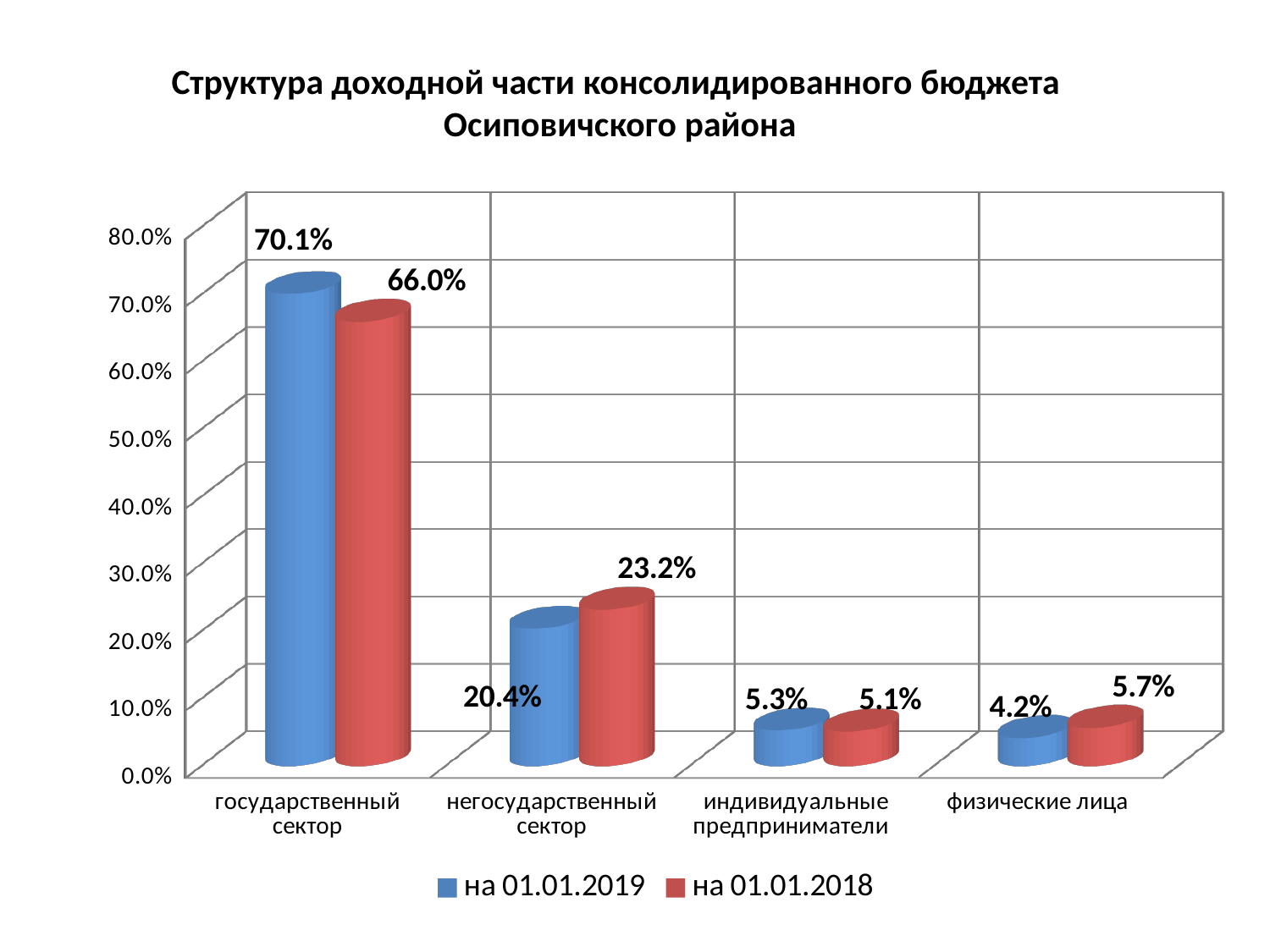
Which category has the lowest value in the series на 01.01.2019? физические лица How many series does the legend list? 2 Which is larger for негосударственный сектор: the value на 01.01.2019 or на 01.01.2018? на 01.01.2018 Which category has the highest value in the series на 01.01.2018? государственный сектор What colour are the bars for the series на 01.01.2018? red How many categories are shown on the x axis? 4 What is the value for негосударственный сектор in the series на 01.01.2018? 23.2% What is the value for индивидуальные предприниматели in the series на 01.01.2018? 5.1% What is the value for физические лица in the series на 01.01.2019? 4.2% What kind of chart is shown on the slide? bar chart What is the difference between the на 01.01.2019 and на 01.01.2018 values for государственный сектор? 4.1% What is the value for государственный сектор in the series на 01.01.2019? 70.1%